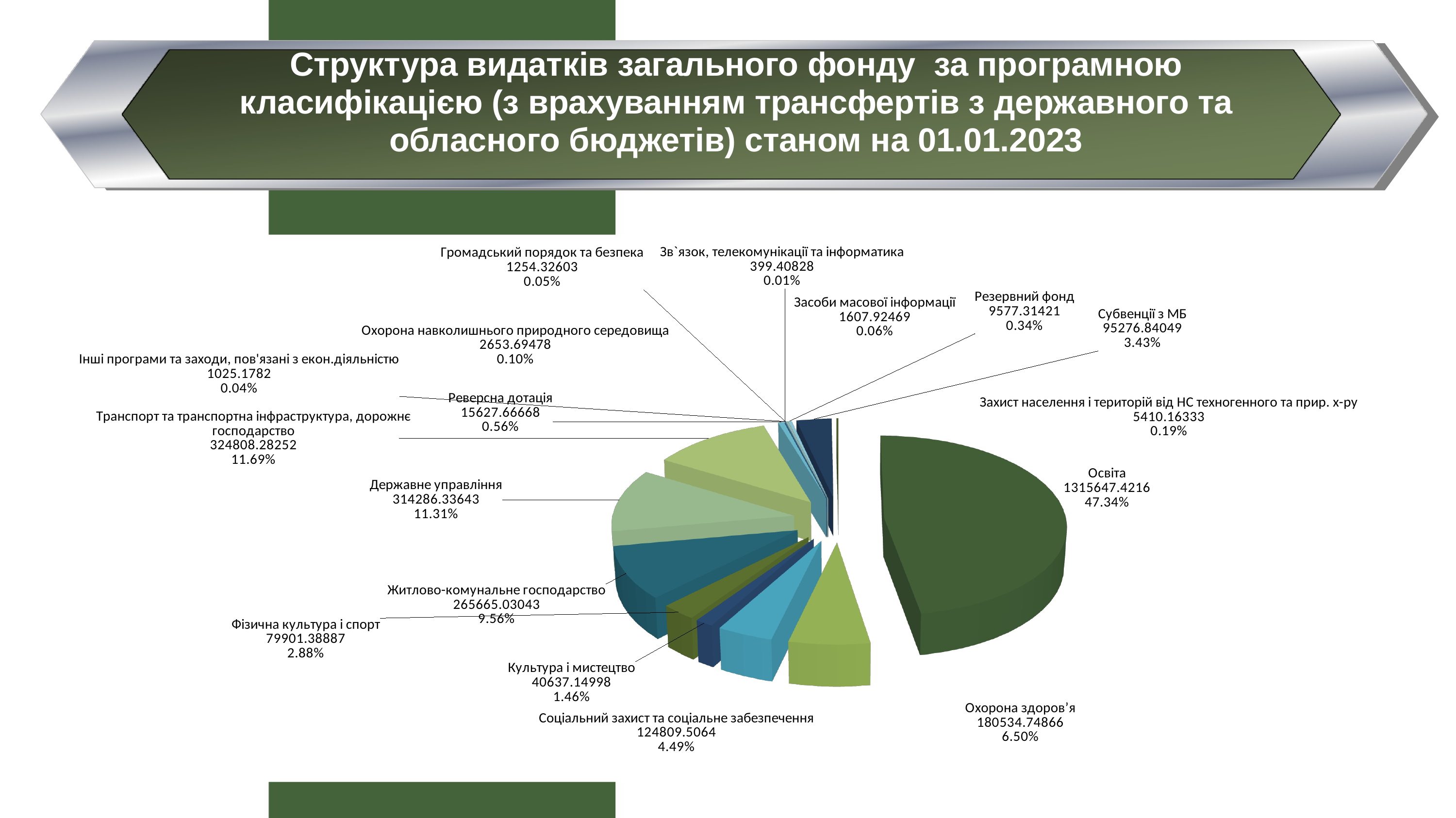
What percentage share does Транспорт та транспортна інфраструктура, дорожнє господарство have? 11.69% What percentage share does Резервний фонд have? 0.34% What is the value shown for Освіта? 1315647.4216 How many categories are shown in the pie chart? 17 Which is larger: Житлово-комунальне господарство or Соціальний захист та соціальне забезпечення? Житлово-комунальне господарство What percentage share does Освіта have? 47.34% What is the difference between the values for Транспорт та транспортна інфраструктура, дорожнє господарство and Державне управління? 10521.94609 What is the value shown for Охорона здоров’я? 180534.74866 What kind of chart is shown on the slide? Pie chart Which category has the smallest share of the pie? Зв`язок, телекомунікації та інформатика Which category has the largest share of the pie? Освіта What is the value shown for Державне управління? 314286.33643